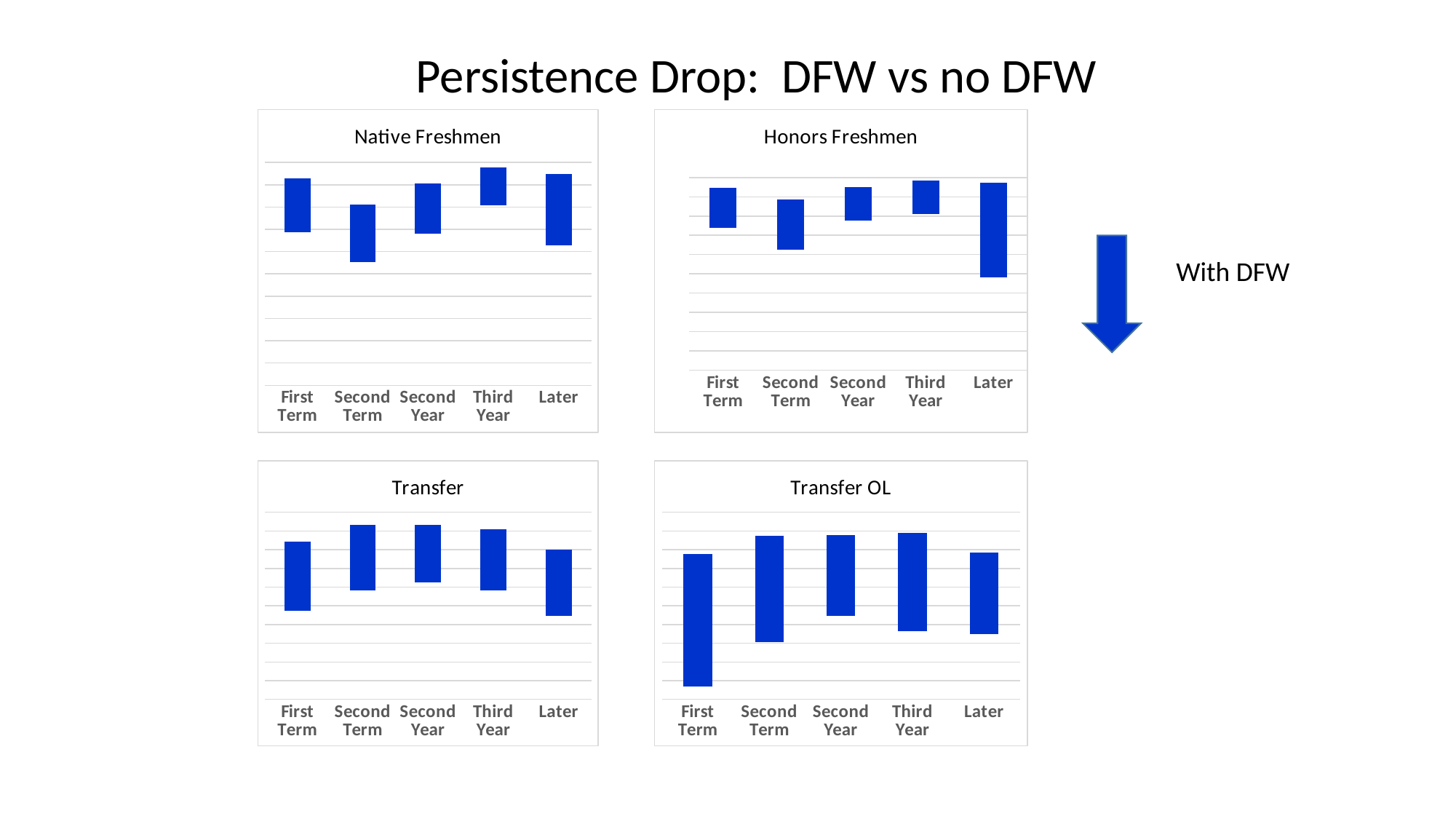
In the Native Freshmen chart, which category has the shortest bar? Third Year What kind of chart is the Honors Freshmen chart? Bar chart In the Honors Freshmen chart, which category has the longest bar? Later What is the title of the chart in the bottom-right position of the slide? Transfer OL In the Native Freshmen chart, which category has the longest bar? Later In the Transfer OL chart, how many bars are plotted? 5 In the Transfer OL chart, which category has the longest bar? First Term In the Native Freshmen chart, how many categories are shown on the x axis? 5 How many charts are shown on the slide? 4 In the Transfer OL chart, is the bar for First Term longer or shorter than the bar for Later? Longer What kind of chart is the Transfer chart? Bar chart What is the first category label on the x axis of the Transfer chart? First Term